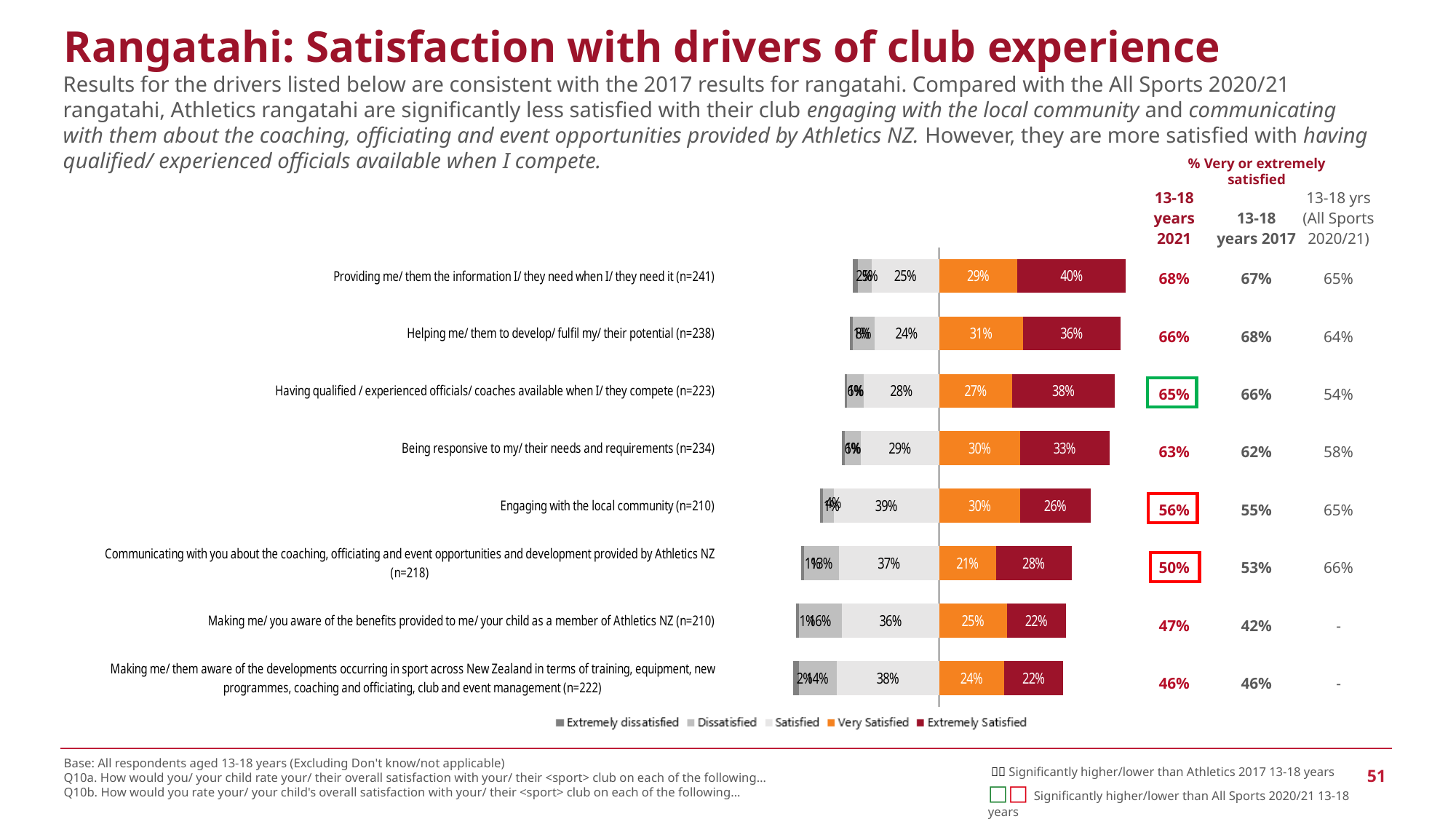
Which driver has the lowest Very Satisfied value? Communicating with you about the coaching, officiating and event opportunities and development provided by Athletics NZ (21%) What is the Extremely Satisfied value for 'Providing me/ them the information I/ they need when I/ they need it'? 40% How many drivers (categories) are plotted in the chart? 8 What is the Very Satisfied value for 'Helping me/ them to develop/ fulfil my/ their potential'? 31% What is the first entry in the chart legend? Extremely dissatisfied Which driver has the highest Extremely Satisfied value? Providing me/ them the information I/ they need when I/ they need it (40%) How many series does the chart legend list? 5 In the '% Very or extremely satisfied' column for 13-18 years 2021, what is the value for 'Engaging with the local community'? 56% What is the difference between the Extremely Satisfied values for 'Having qualified / experienced officials/ coaches available' (38%) and 'Being responsive to my/ their needs and requirements' (33%)? 5 percentage points What kind of chart is shown on the slide? Stacked bar chart What is the Satisfied value for 'Engaging with the local community'? 39% Which has the larger Satisfied value: 'Making me/ you aware of the benefits provided' or 'Making me/ them aware of the developments occurring in sport across New Zealand'? Making me/ them aware of the developments occurring in sport across New Zealand (38%)